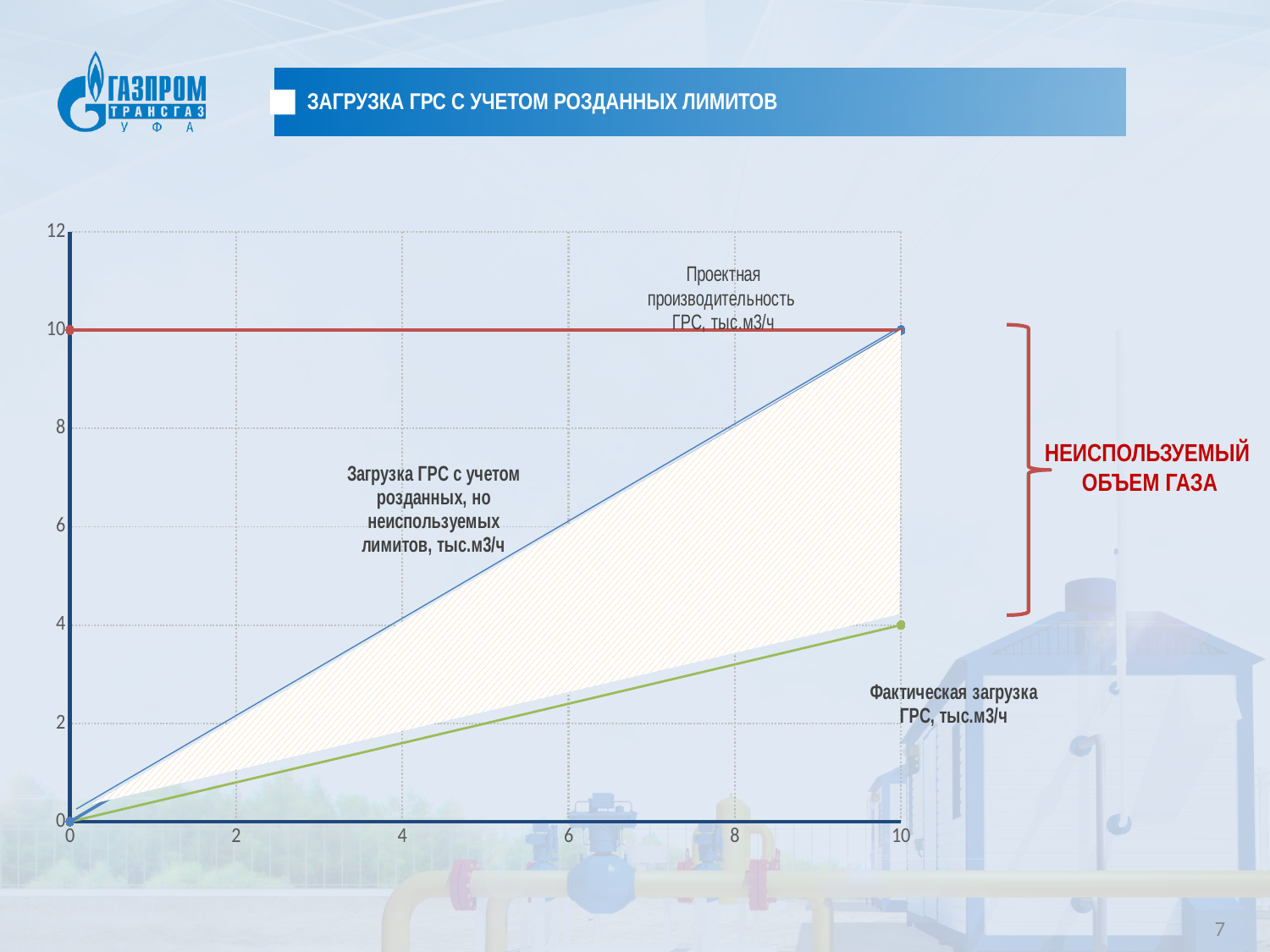
Which line is lower at x = 10: the green "Фактическая загрузка ГРС" line or the red "Проектная производительность ГРС" line? Фактическая загрузка ГРС Does the green "Фактическая загрузка ГРС" line rise or fall as x increases? rise What is the maximum value shown on the y axis? 12 Is the value of the green line at x = 6 greater or less than 4? less What value does the green line "Фактическая загрузка ГРС, тыс.м3/ч" reach at x = 10? 4 What kind of chart is shown on the slide? line chart What does the red bracket to the right of the chart label? НЕИСПОЛЬЗУЕМЫЙ ОБЪЕМ ГАЗА Does the red "Проектная производительность ГРС" line rise, fall or stay flat across the x axis? stay flat What is the difference between the design capacity (red line) and the actual load (green line) at x = 10? 6 Is the value of the blue line at x = 8 greater or less than 6? greater What value does the blue line "Загрузка ГРС с учетом розданных, но неиспользуемых лимитов" reach at x = 10? 10 What is the value of the red line labelled "Проектная производительность ГРС, тыс.м3/ч"? 10